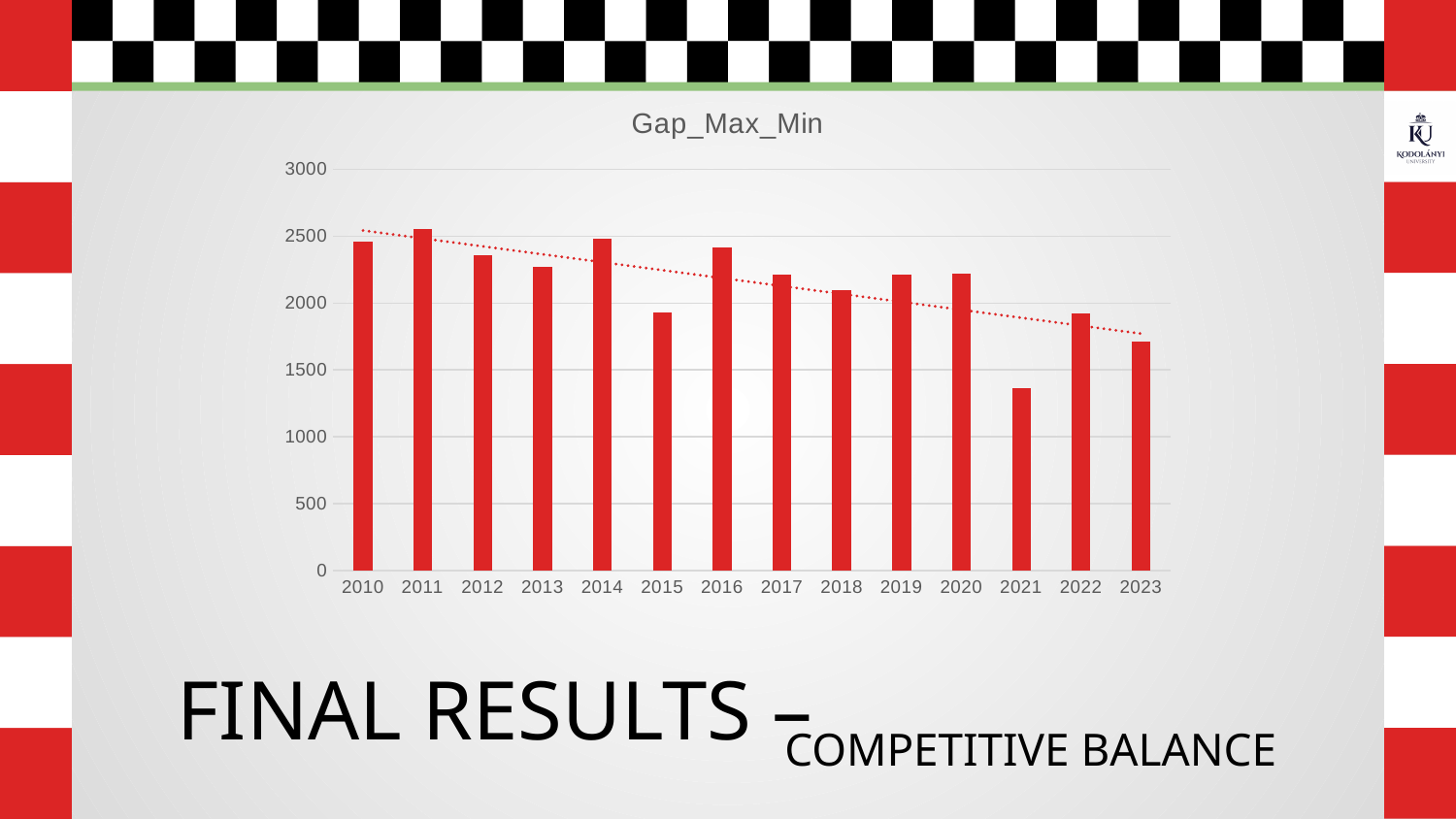
What type of chart is shown on the slide? bar chart Is the value for 2021 greater or less than 1500? less Which year has the lowest value in the chart? 2021 Which is larger, the value for 2021 or the value for 2022? 2022 Is the value for 2023 greater or less than 2000? less How many years (bars) are plotted in the chart? 14 Which year has the highest value in the chart? 2011 What is the title of the chart? Gap_Max_Min Which is larger, the value for 2015 or the value for 2016? 2016 Is the value for 2010 greater or less than 2000? greater Do the values generally rise or fall from 2010 to 2023? fall